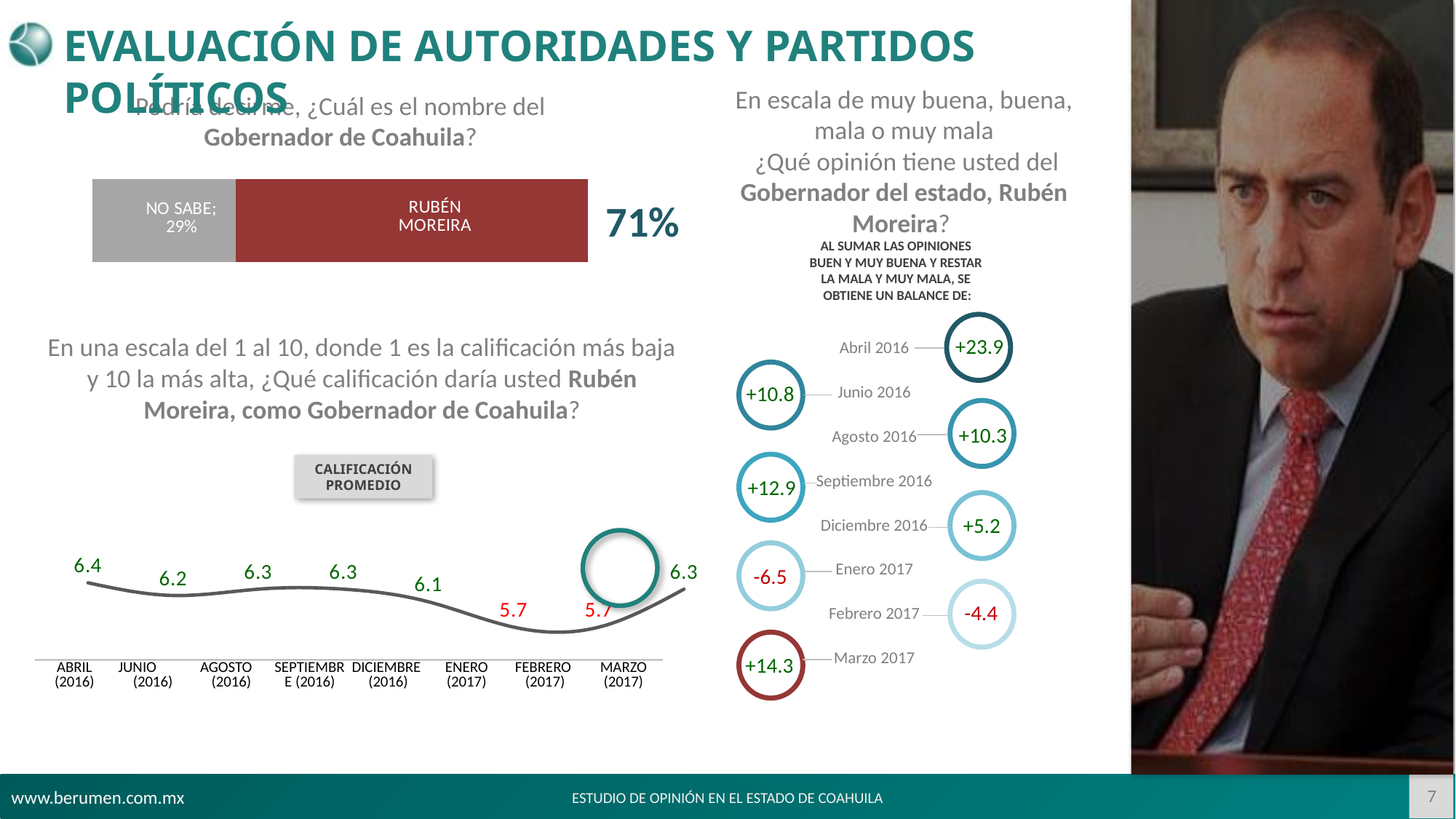
In the horizontal bar chart at the top left, what percentage corresponds to 'RUBÉN MOREIRA'? 71% In the balance diagram on the right, which month has the lowest balance? Enero 2017 In the horizontal bar chart at the top left, what percentage corresponds to 'NO SABE'? 29% What kind of chart is the 'CALIFICACIÓN PROMEDIO' chart? line chart In the balance diagram on the right, what is the balance for Marzo 2017? +14.3 In the 'CALIFICACIÓN PROMEDIO' line chart, what is the value for MARZO (2017)? 6.3 In the 'CALIFICACIÓN PROMEDIO' line chart, which month has the highest value? ABRIL (2016) In the 'CALIFICACIÓN PROMEDIO' line chart, how many data points are plotted? 8 In the 'CALIFICACIÓN PROMEDIO' line chart, is the value for DICIEMBRE (2016) larger or smaller than the value for FEBRERO (2017)? larger In the 'CALIFICACIÓN PROMEDIO' line chart, what is the value for ABRIL (2016)? 6.4 In the 'CALIFICACIÓN PROMEDIO' line chart, what is the difference between the value for ABRIL (2016) and the value for ENERO (2017)? 0.7 In the balance diagram on the right, what is the balance for Abril 2016? +23.9